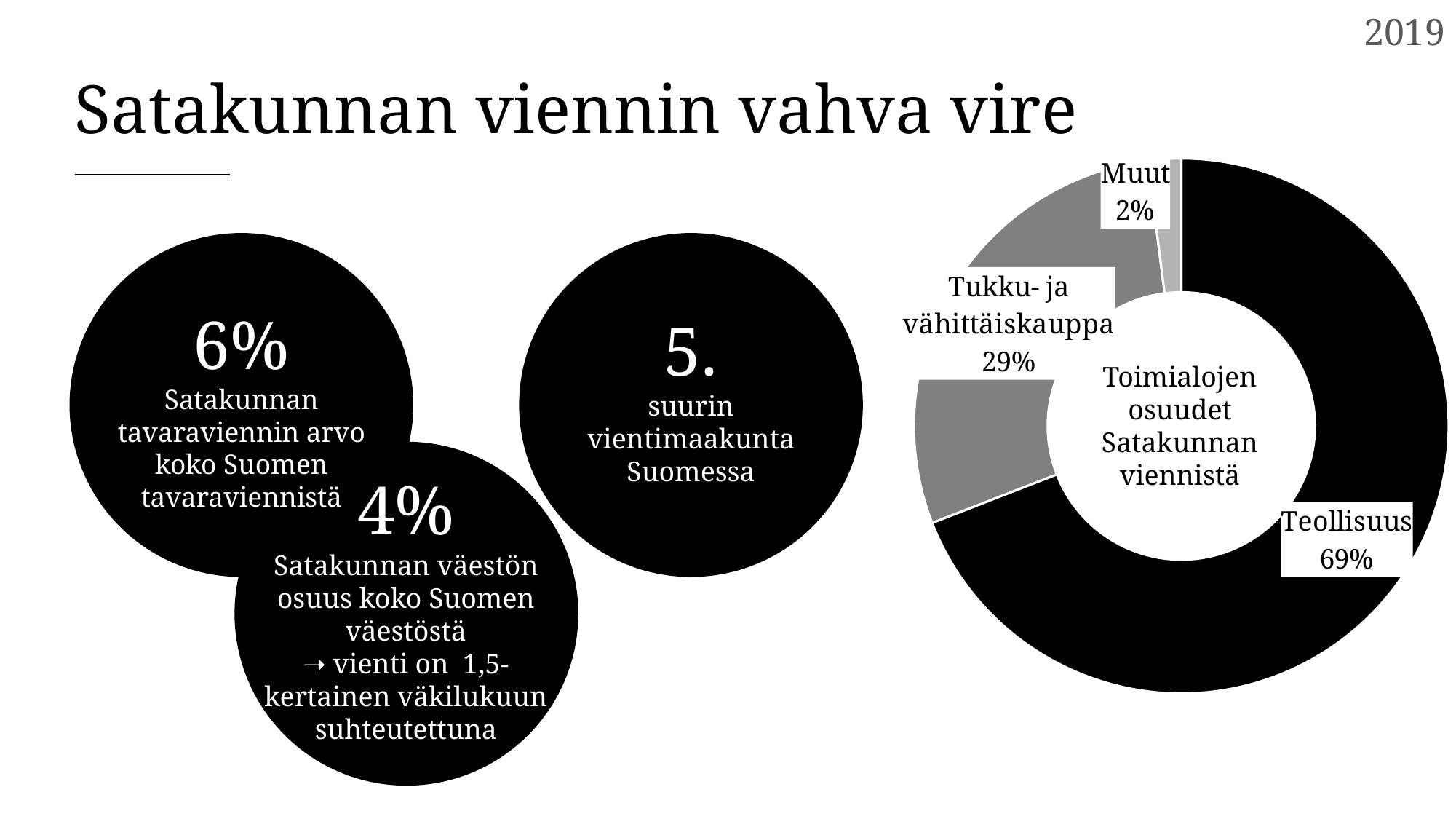
What is the title shown in the centre of the doughnut chart? Toimialojen osuudet Satakunnan viennistä Which sector has the smallest share in the doughnut chart? Muut How many slices does the doughnut chart have? 3 What share does the Muut slice have in the doughnut chart? 2% What is the difference in percentage points between Teollisuus and Tukku- ja vähittäiskauppa in the doughnut chart? 40 percentage points What share of Satakunta's exports does Teollisuus account for in the doughnut chart? 69% What share does Tukku- ja vähittäiskauppa have in the doughnut chart? 29% What type of chart is shown on the right side of the slide? Doughnut chart Which is larger in the doughnut chart, Tukku- ja vähittäiskauppa or Muut? Tukku- ja vähittäiskauppa What colour is the Teollisuus slice in the doughnut chart? Black What is the combined share of Tukku- ja vähittäiskauppa and Muut in the doughnut chart? 31% Which sector has the largest share in the doughnut chart? Teollisuus